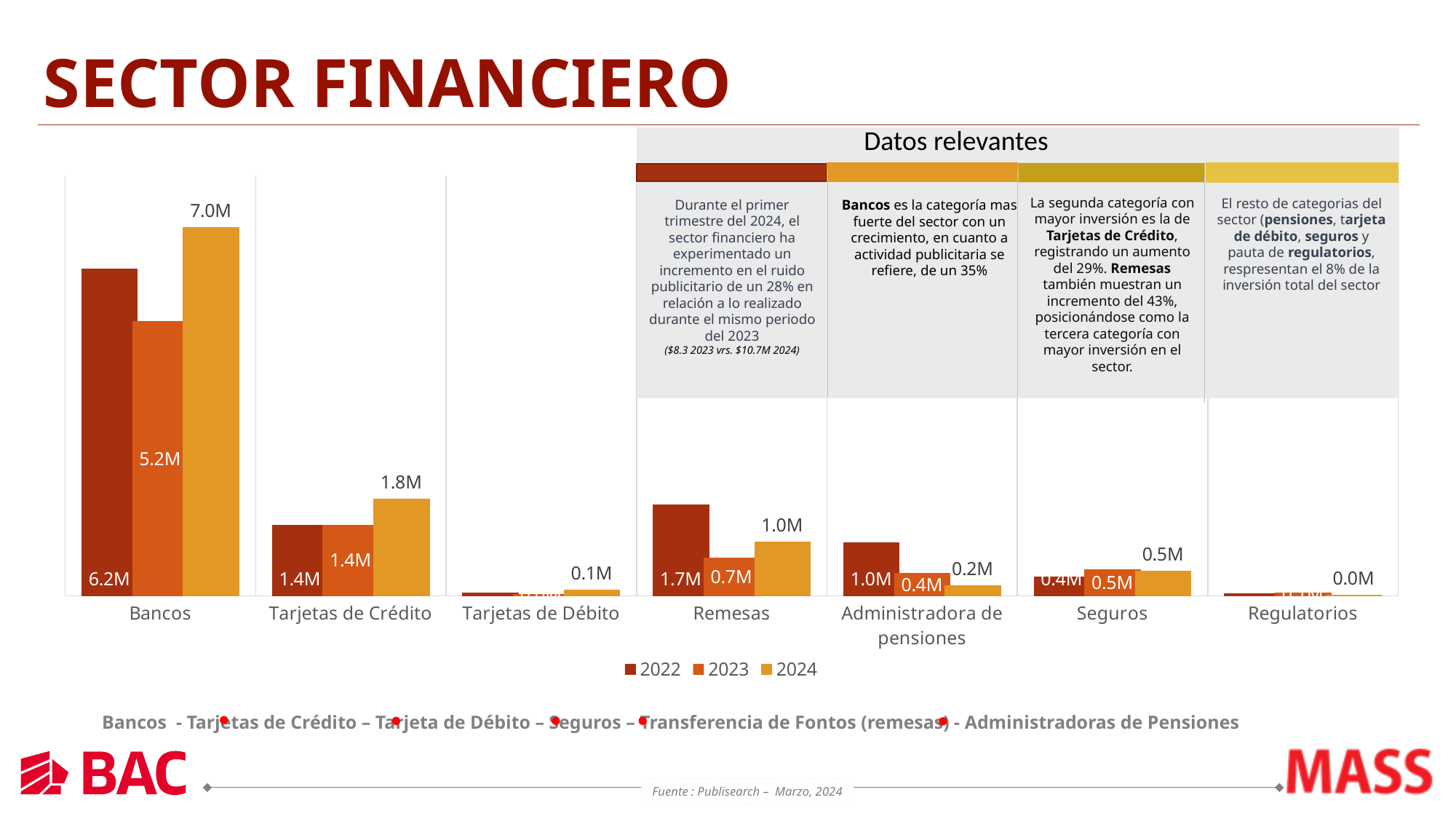
What is the value for Bancos in 2024? 7.0M What is the value for Tarjetas de Crédito in 2024? 1.8M What is the value for Bancos in 2023? 5.2M Which category has the highest value in 2024? Bancos What kind of chart is shown on the slide? Bar chart How many categories are shown on the x axis? 7 Which category has the lowest value in 2024? Regulatorios How many series does the legend list? 3 Which is larger for Remesas: the 2022 value or the 2024 value? 2022 What is the value for Administradora de pensiones in 2024? 0.2M What is the value for Remesas in 2022? 1.7M What is the difference between the 2024 and 2023 values for Bancos? 1.8M